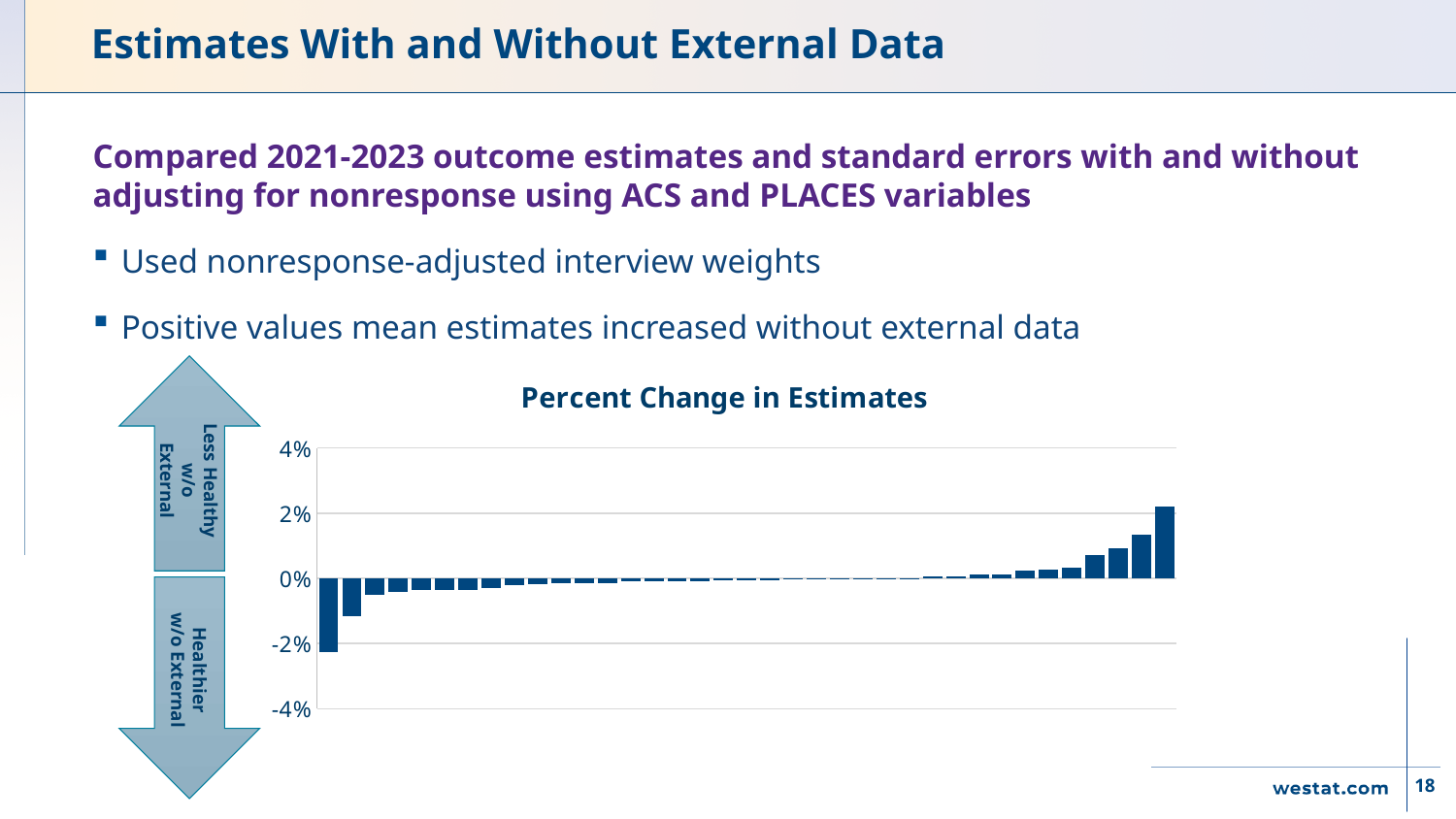
Is the value of the rightmost bar greater or less than 0%? greater Do the bar values rise or fall moving from left to right along the x axis? rise Which bar has the lowest value, the leftmost or the rightmost? the leftmost What is the title of the chart? Percent Change in Estimates Is the value of the leftmost bar greater or less than -4%? greater Which is larger, the value of the second bar from the left or the value of the second bar from the right? the second bar from the right What kind of chart is shown on the slide? bar chart Is the value of the leftmost bar greater or less than 0%? less Which bar has the highest value, the leftmost or the rightmost? the rightmost What are the highest and lowest tick values shown on the y axis? 4% and -4%